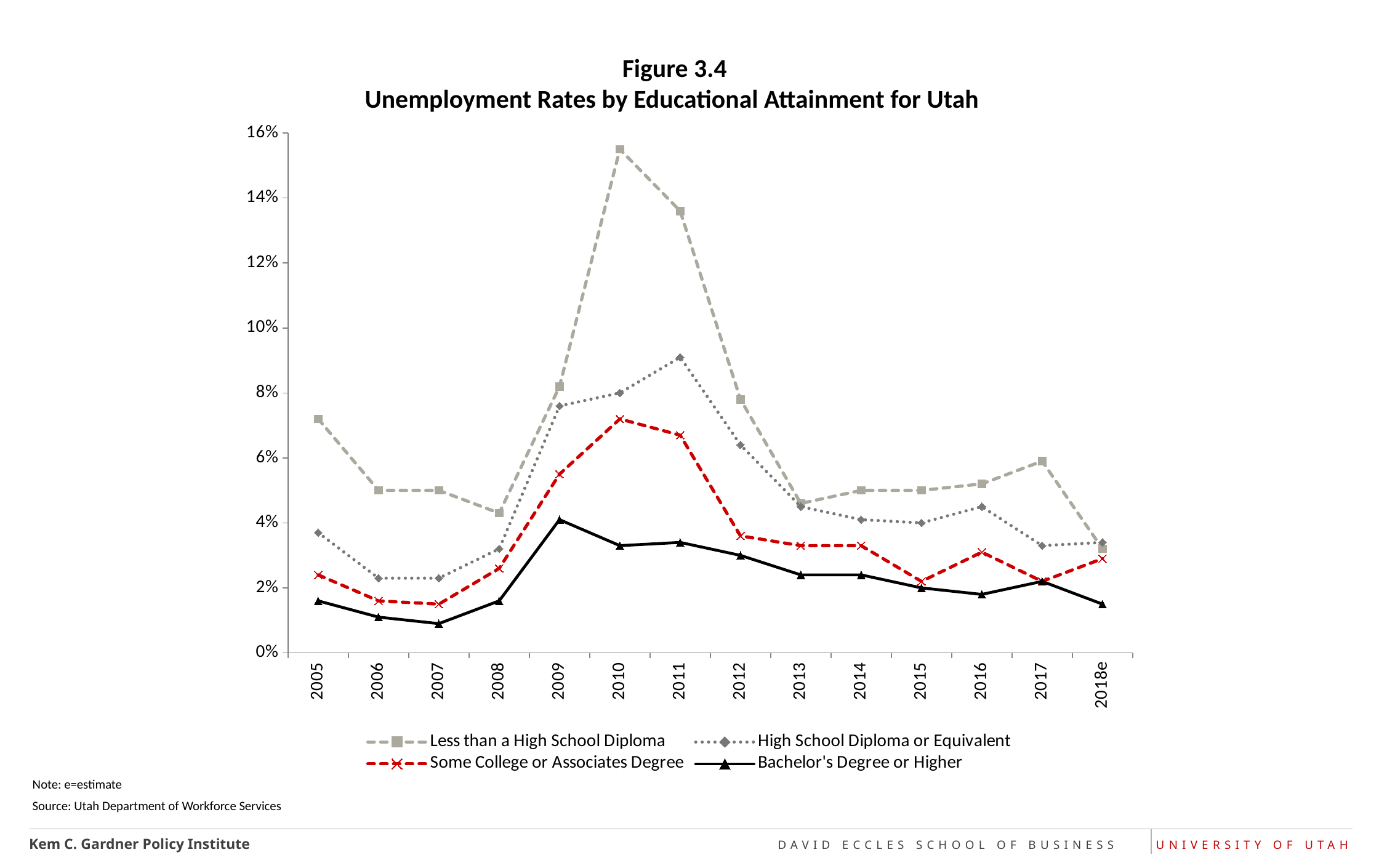
In 2011, which is larger: High School Diploma or Equivalent or Some College or Associates Degree? High School Diploma or Equivalent How many years are shown along the x axis? 14 According to the note on the slide, what does the 'e' in 2018e stand for? estimate In which year does the Less than a High School Diploma series reach its highest value? 2010 Which series has the highest value in 2010? Less than a High School Diploma What kind of chart is shown on the slide? line chart Between 2011 and 2013, does the Less than a High School Diploma series rise or fall? fall Which series has the lowest value in 2010? Bachelor's Degree or Higher Is the value for Less than a High School Diploma in 2010 greater or less than 14%? greater Is the value for Bachelor's Degree or Higher in 2009 greater or less than 6%? less Is the value for High School Diploma or Equivalent in 2011 greater or less than 8%? greater How many series does the legend list? 4